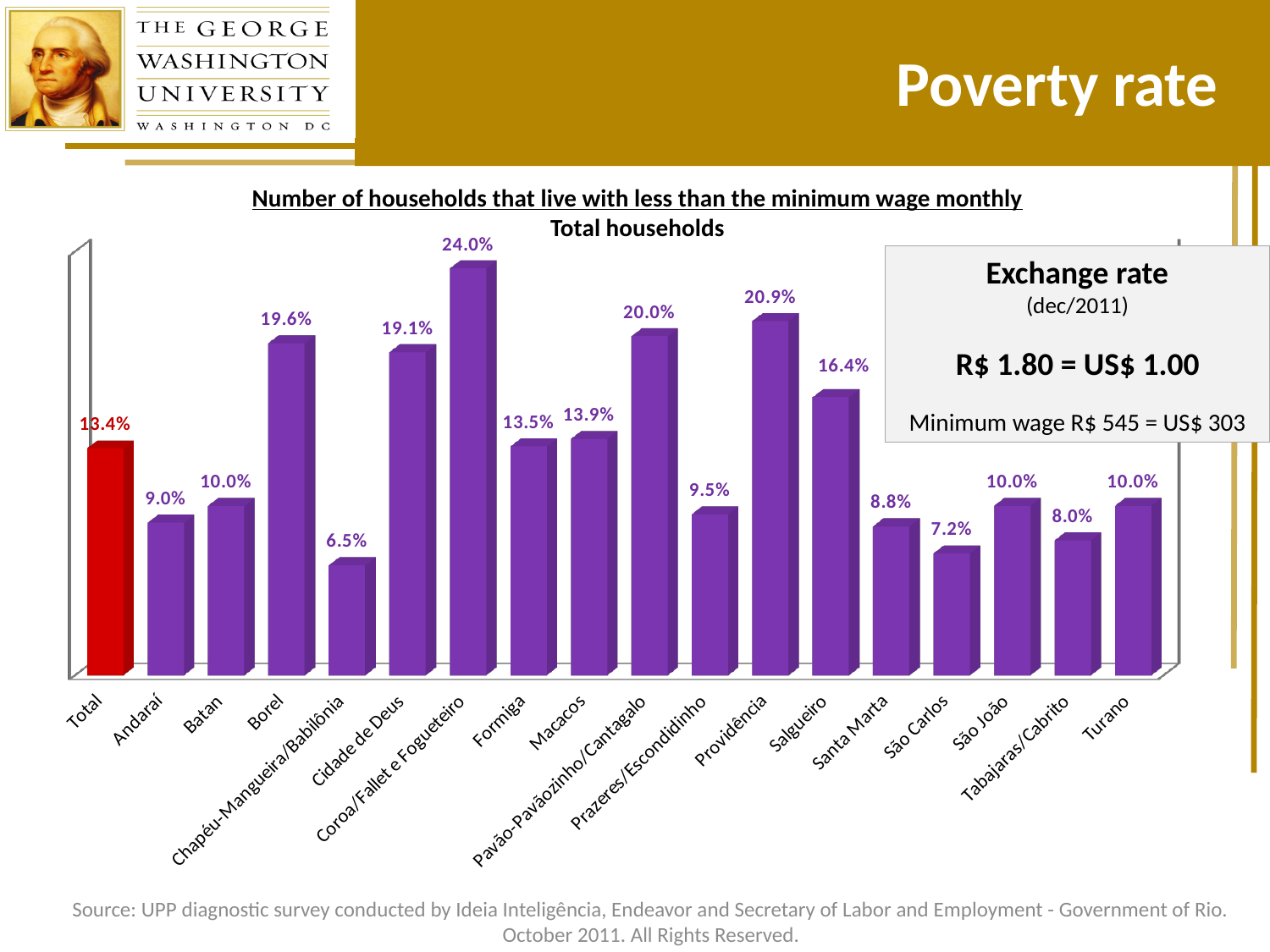
Which community has the highest value? Coroa/Fallet e Fogueteiro Which is larger, the value for Salgueiro or the value for Santa Marta? Salgueiro Which is larger, the value for Cidade de Deus or the value for Pavão-Pavãozinho/Cantagalo? Pavão-Pavãozinho/Cantagalo What is the value shown for Total? 13.4% What is the value for Chapéu-Mangueira/Babilônia? 6.5% What is the value for Coroa/Fallet e Fogueteiro? 24.0% What is the value for Providência? 20.9% Which bar is coloured red rather than purple? Total How many categories are shown on the x axis? 18 Which community has the lowest value? Chapéu-Mangueira/Babilônia What kind of chart is shown on the slide? Bar chart What is the difference between the values for Borel and Andaraí? 10.6%